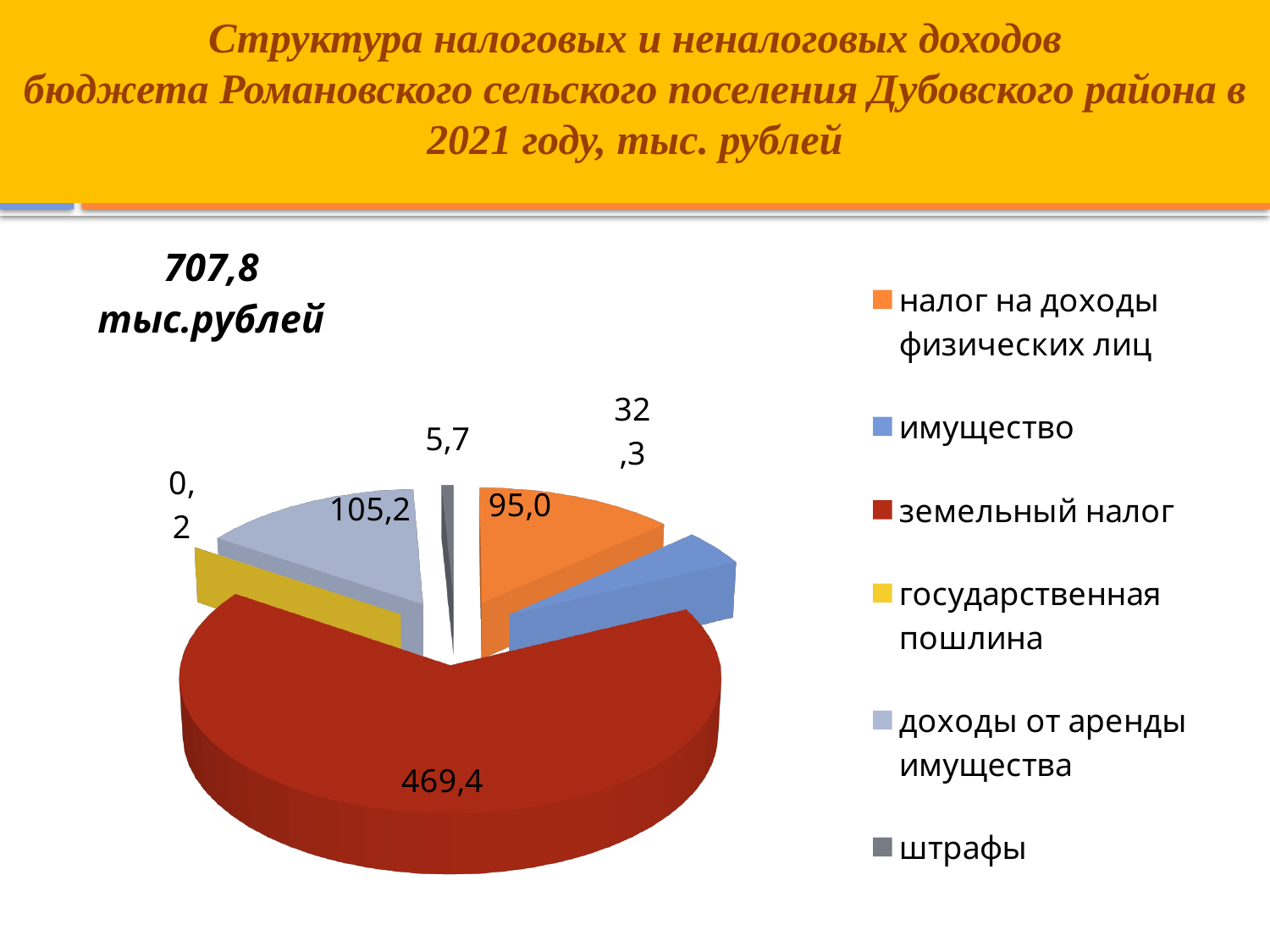
Which category has the largest value? земельный налог Which category has the smallest value? государственная пошлина Which is larger, доходы от аренды имущества or налог на доходы физических лиц? доходы от аренды имущества What is the value for штрафы? 5,7 What kind of chart is shown on the slide? pie chart What is the value for земельный налог? 469,4 What is the value for имущество? 32,3 What total value in тыс. рублей is stated on the slide for the chart? 707,8 What is the value for доходы от аренды имущества? 105,2 What is the difference between земельный налог and доходы от аренды имущества? 364,2 What is the value for налог на доходы физических лиц? 95,0 How many categories does the pie chart show? 6